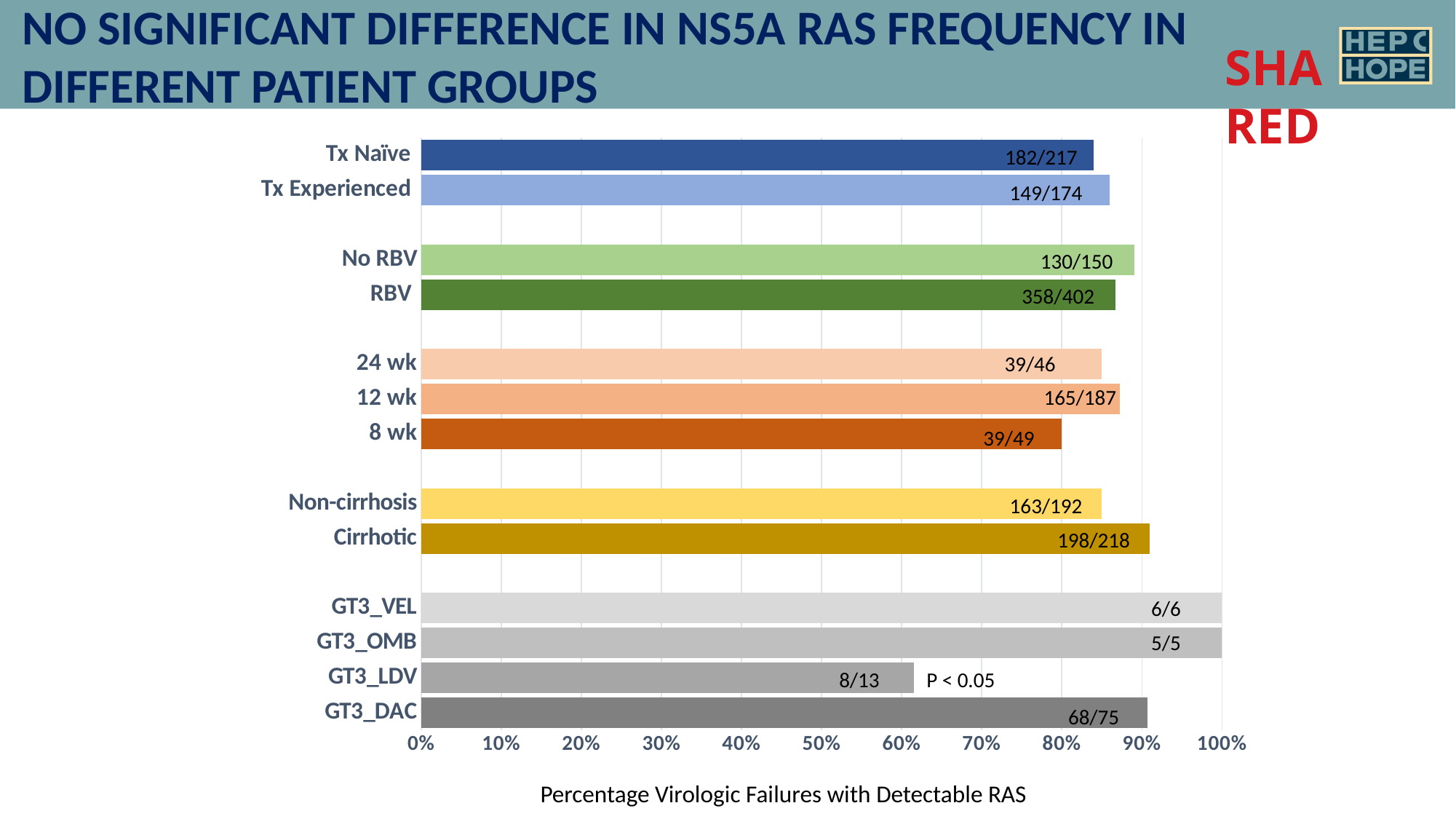
What data label is shown on the 12 wk bar? 165/187 Is the value for No RBV greater or less than 80%? greater What data label is shown on the RBV bar? 358/402 What data label is shown on the GT3_LDV bar? 8/13 Which has the larger percentage, 8 wk or 12 wk? 12 wk How many categories (bars) are plotted in the chart? 13 Is the value for GT3_LDV greater or less than 70%? less Which category has the lowest percentage of virologic failures with detectable RAS? GT3_LDV What data label is shown on the Cirrhotic bar? 198/218 What data label is shown on the Tx Naïve bar? 182/217 What kind of chart is shown on the slide? Bar chart What is the x-axis title of the chart? Percentage Virologic Failures with Detectable RAS